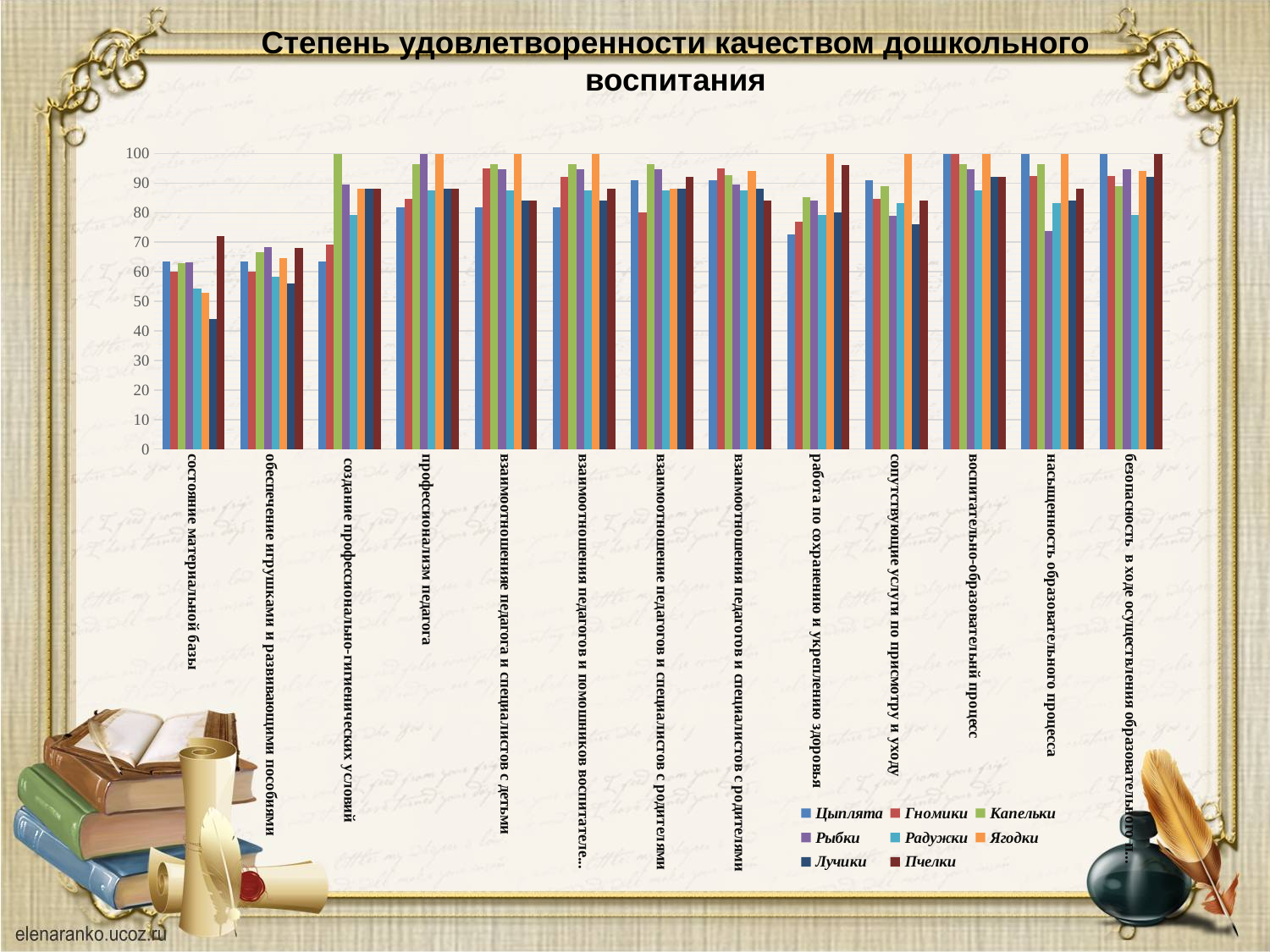
Is the value for Цыплята in 'работа по сохранению и укреплению здоровья' greater or less than 80? less Which series has the highest value for 'состояние материальной базы'? Пчелки Which series is listed first in the legend? Цыплята Is the value for Лучики in 'состояние материальной базы' greater or less than 50? less How many categories are shown along the x axis? 13 What is the title of the chart? Степень удовлетворенности качеством дошкольного воспитания For 'состояние материальной базы', which is larger: the value for Пчелки or the value for Цыплята? Пчелки How many series does the legend list? 8 Is the value for Капельки in 'создание профессионально-гигиенических условий' greater or less than 90? greater Which series has the lowest value for 'состояние материальной базы'? Лучики For 'создание профессионально-гигиенических условий', which is larger: the value for Капельки or the value for Радужки? Капельки What kind of chart is shown on the slide? bar chart